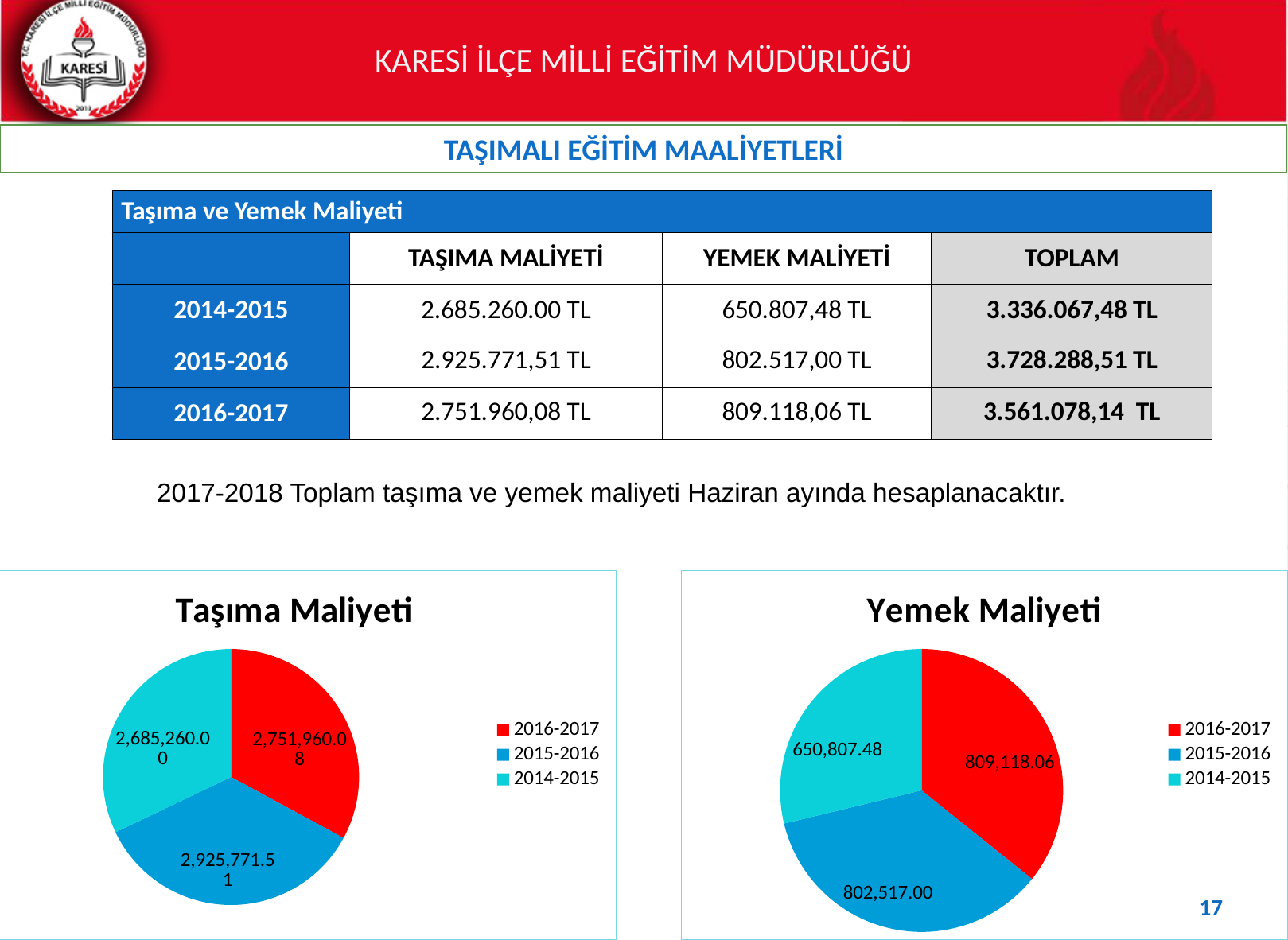
In the Yemek Maliyeti chart, what is the difference between the 2016-2017 and 2014-2015 values? 158,310.58 How many slices does the Taşıma Maliyeti pie chart have? 3 In the Taşıma Maliyeti chart, what is the difference between the 2015-2016 and 2014-2015 values? 240,511.51 In the Yemek Maliyeti chart, which year has the smallest slice? 2014-2015 In the Yemek Maliyeti chart, which is larger, the value for 2016-2017 or 2015-2016? 2016-2017 In the Yemek Maliyeti chart, what is the value for 2014-2015? 650,807.48 In the Taşıma Maliyeti chart, what is the value for 2015-2016? 2,925,771.51 In the Taşıma Maliyeti chart, which year has the largest slice? 2015-2016 In the Taşıma Maliyeti chart, what is the value for 2014-2015? 2,685,260.00 What type of chart is the Yemek Maliyeti chart? Pie chart In the Yemek Maliyeti chart, what is the value for 2016-2017? 809,118.06 In the Yemek Maliyeti chart, which colour represents 2015-2016? Blue